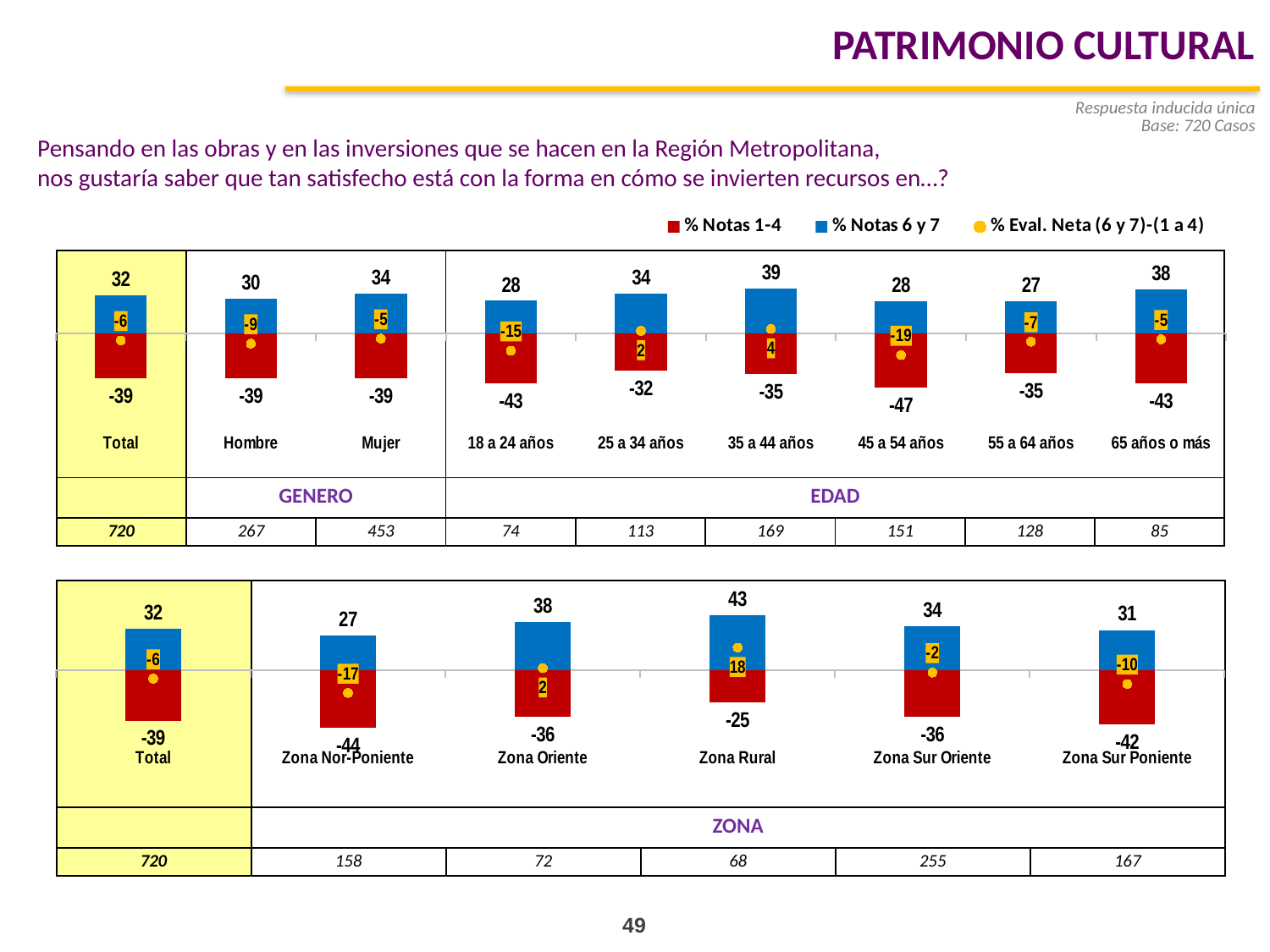
In the top chart, what is the % Eval. Neta value for 18 a 24 años? -15 In the top chart, what is the % Notas 6 y 7 value for 35 a 44 años? 39 In the bottom chart, which is larger, the % Notas 6 y 7 value for Zona Oriente or for Zona Sur Poniente? Zona Oriente In the top chart, what is the % Notas 1-4 value for 45 a 54 años? -47 In the top chart, which age group has the highest % Notas 6 y 7 value? 35 a 44 años In the top chart, what is the difference between the % Notas 6 y 7 values for Mujer and Hombre? 4 What kind of chart is shown in the bottom panel? Bar chart In the top chart, which category has the lowest % Eval. Neta value? 45 a 54 años In the bottom chart, what is the % Notas 1-4 value for Zona Nor-Poniente? -44 In the bottom chart, what is the % Eval. Neta value for Zona Rural? 18 How many series does the legend list? 3 In the bottom chart, which zone has the highest % Notas 6 y 7 value? Zona Rural